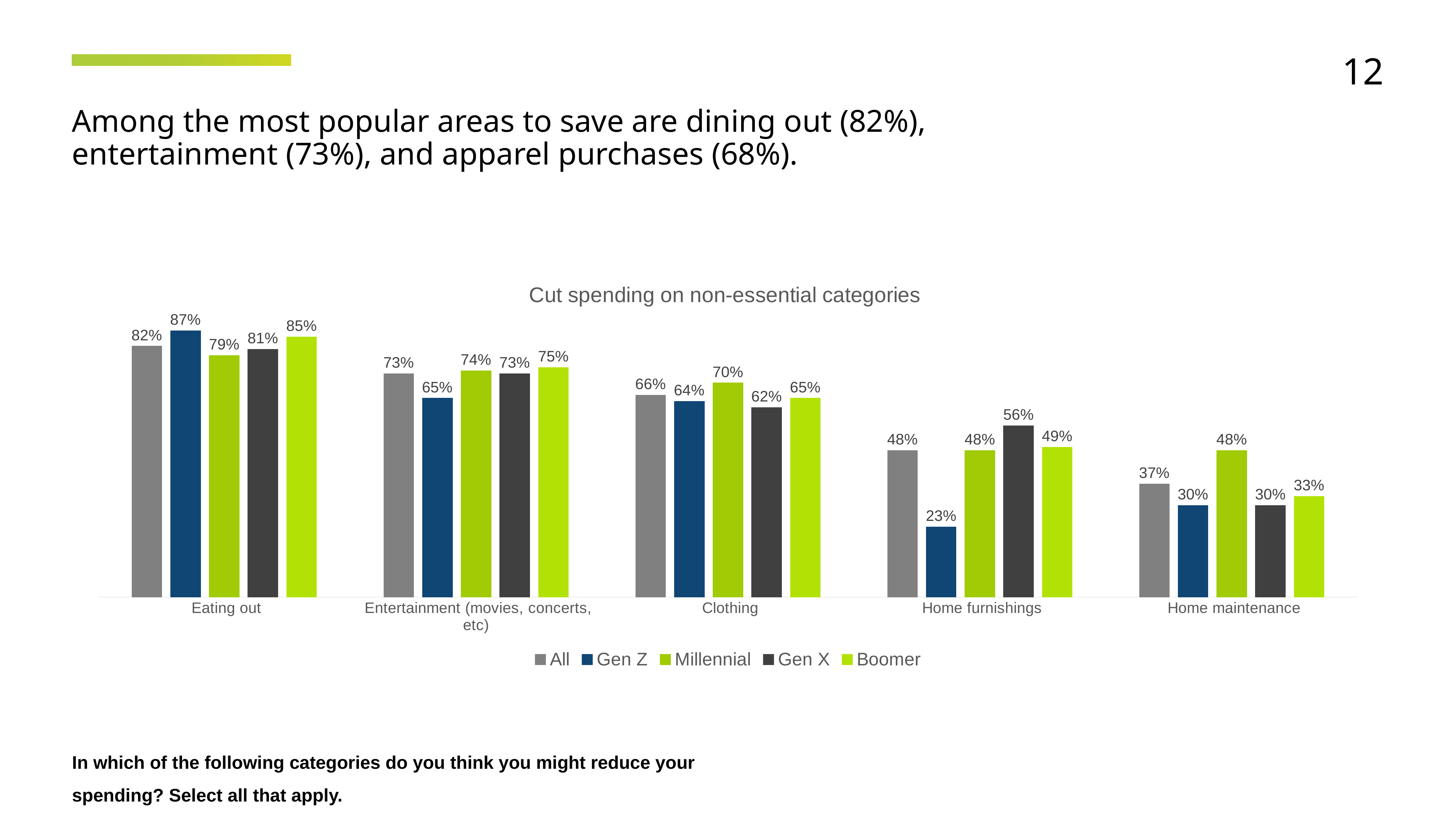
What is the difference between the Gen Z and Millennial values for Home furnishings? 25% What is the value for Gen Z in the Eating out category? 87% Which is larger for Clothing: the Millennial value or the Gen X value? Millennial Which category has the lowest value for Gen Z? Home furnishings How many categories are shown on the x axis? 5 What is the value for Millennial in the Home maintenance category? 48% What is the title of the chart? Cut spending on non-essential categories How many series does the legend list? 5 Do the values for the All series rise or fall from Eating out to Home maintenance? Fall What is the value for Gen X in the Home furnishings category? 56% Which category has the highest value for the All series? Eating out What kind of chart is shown on the slide? Bar chart